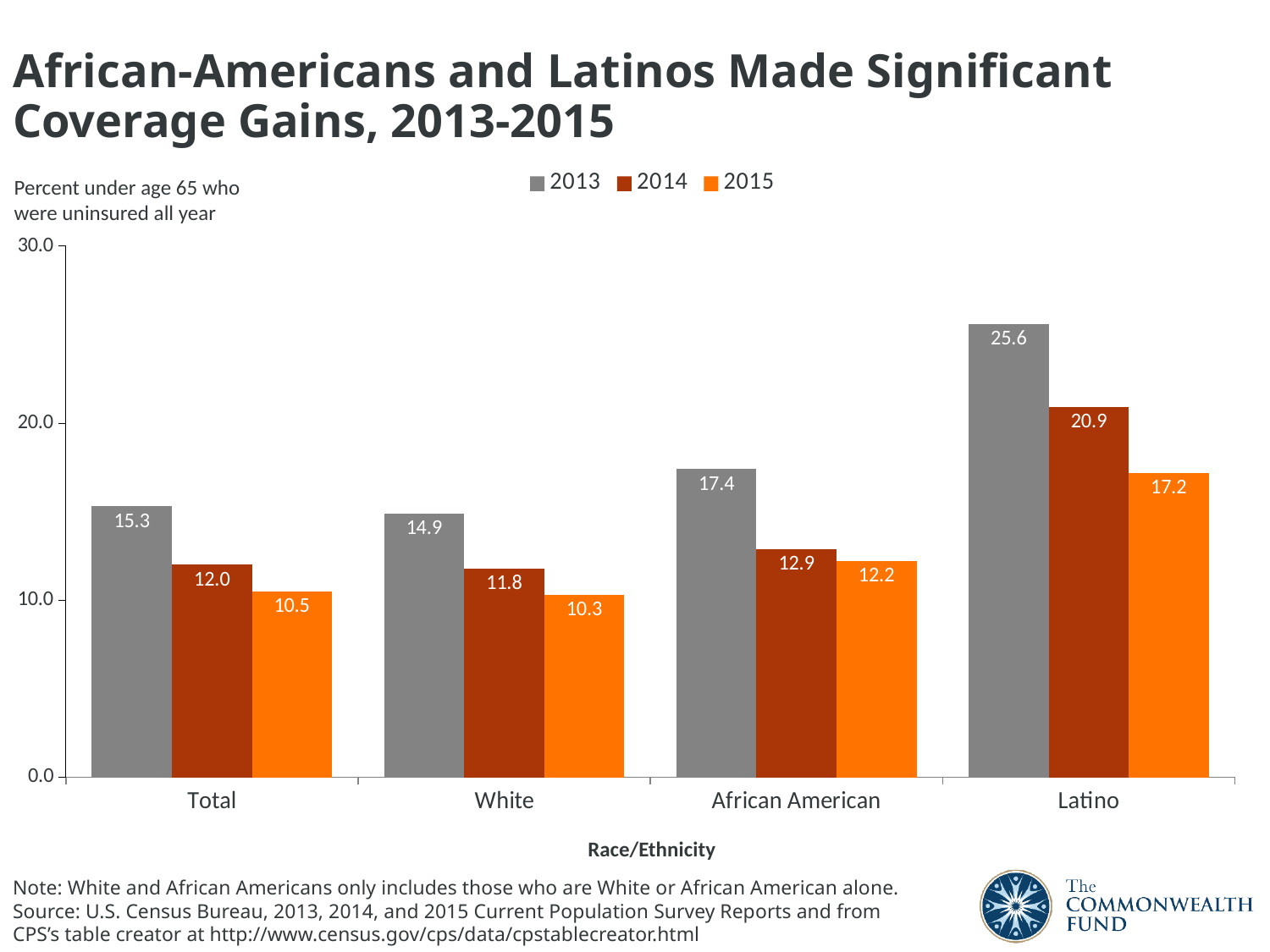
Which is larger: the 2014 value for African Americans or the 2014 value for the Total group? African Americans (12.9) Which race/ethnicity group had the lowest percent uninsured in 2013? White How many race/ethnicity categories are shown on the x axis? 4 What was the percent uninsured all year for African Americans in 2015? 12.2 Which race/ethnicity group had the highest percent uninsured in 2015? Latino What kind of chart is shown on the slide? Bar chart How many series does the legend list? 3 By how many percentage points did the uninsured rate for Latinos fall from 2013 to 2015? 8.4 Is the 2014 value for Latinos greater or less than 20.0? greater What was the percent uninsured all year for Whites in 2014? 11.8 What was the percent uninsured all year for Latinos in 2013? 25.6 What is the difference between the 2013 and 2015 values for African Americans? 5.2